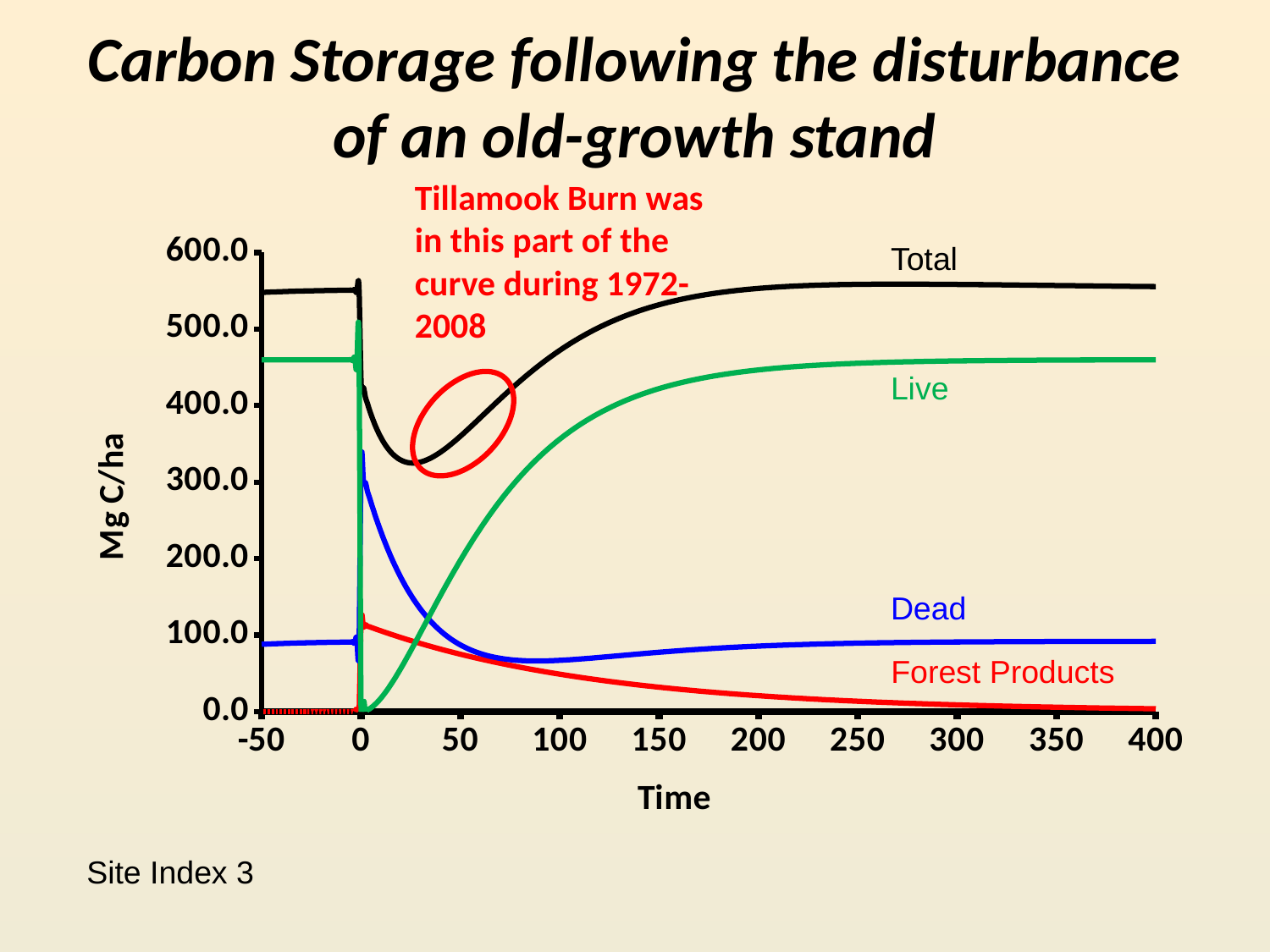
Is the value of the Forest Products series at time 400 greater or less than 100.0? less Is the value of the Live series at time 400 greater or less than 400.0? greater Does the Live series rise or fall between time 0 and time 400? rise Is the value of the Total series at time 400 greater or less than 500.0? greater Which series has the lowest value at time 400? Forest Products At time 400, which is larger: the Live series or the Dead series? Live Which series has the highest value at time 400? Total What kind of chart is shown on the slide? line chart How many series are plotted on the chart? 4 What is the label on the y axis of the chart? Mg C/ha Does the Forest Products series rise or fall between time 0 and time 400? fall